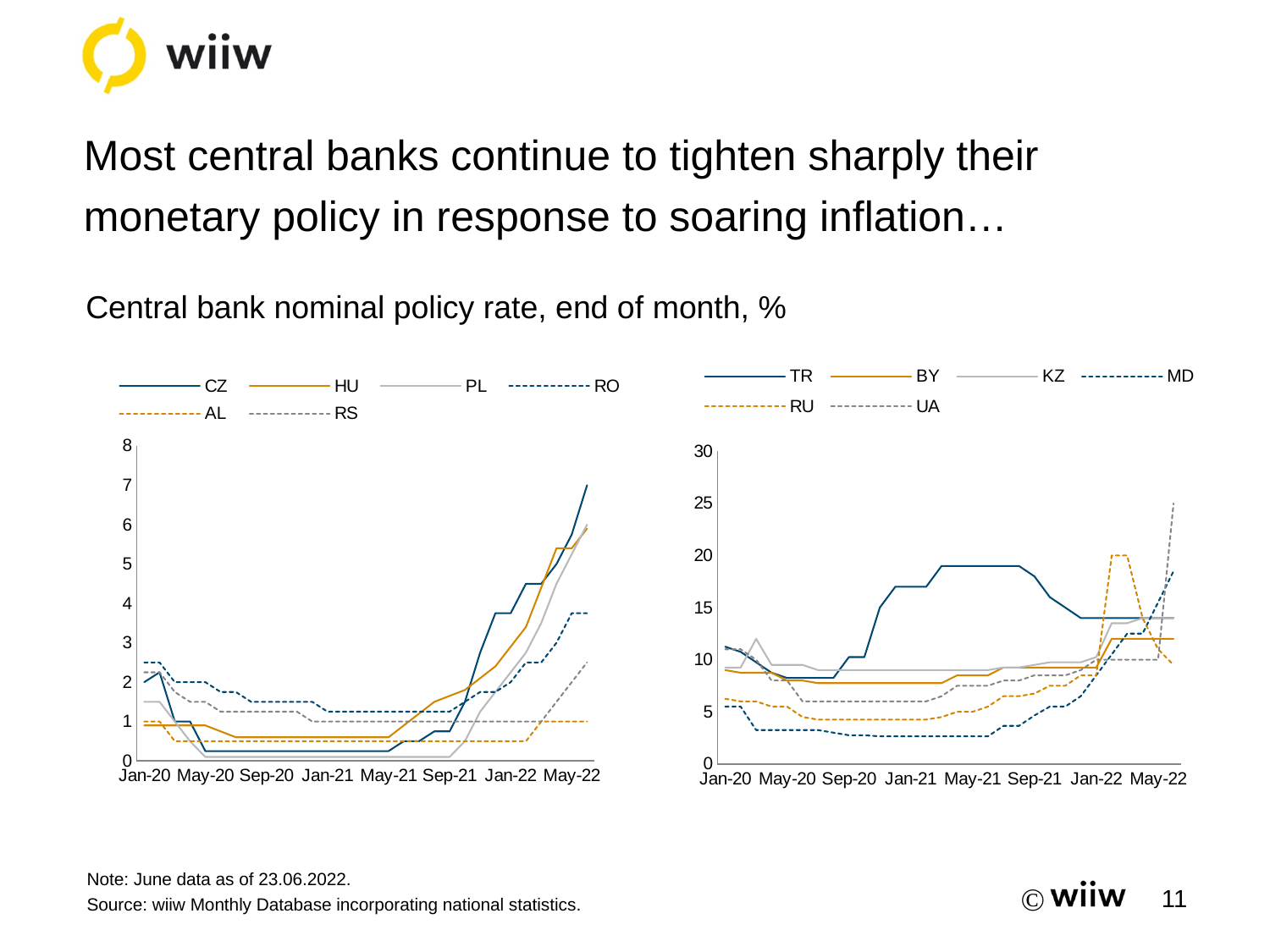
In the right chart, is the peak value for TR during 2021 greater or less than 15? greater In the left chart, is the value for AL at Jan-21 greater or less than 2? less How many series does the legend of the right chart list? 6 In the left chart, which series has the highest value at May-22? CZ How many series does the legend of the left chart list? 6 In the right chart, is the value for MD at Jan-21 greater or less than 5? less In the left chart, does the CZ line rise or fall between Sep-21 and May-22? rise Which series are listed in the legend of the right chart? TR, BY, KZ, MD, RU, UA What kind of chart is the left chart on the slide? line chart In the right chart, which is larger at Jan-21, TR or MD? TR